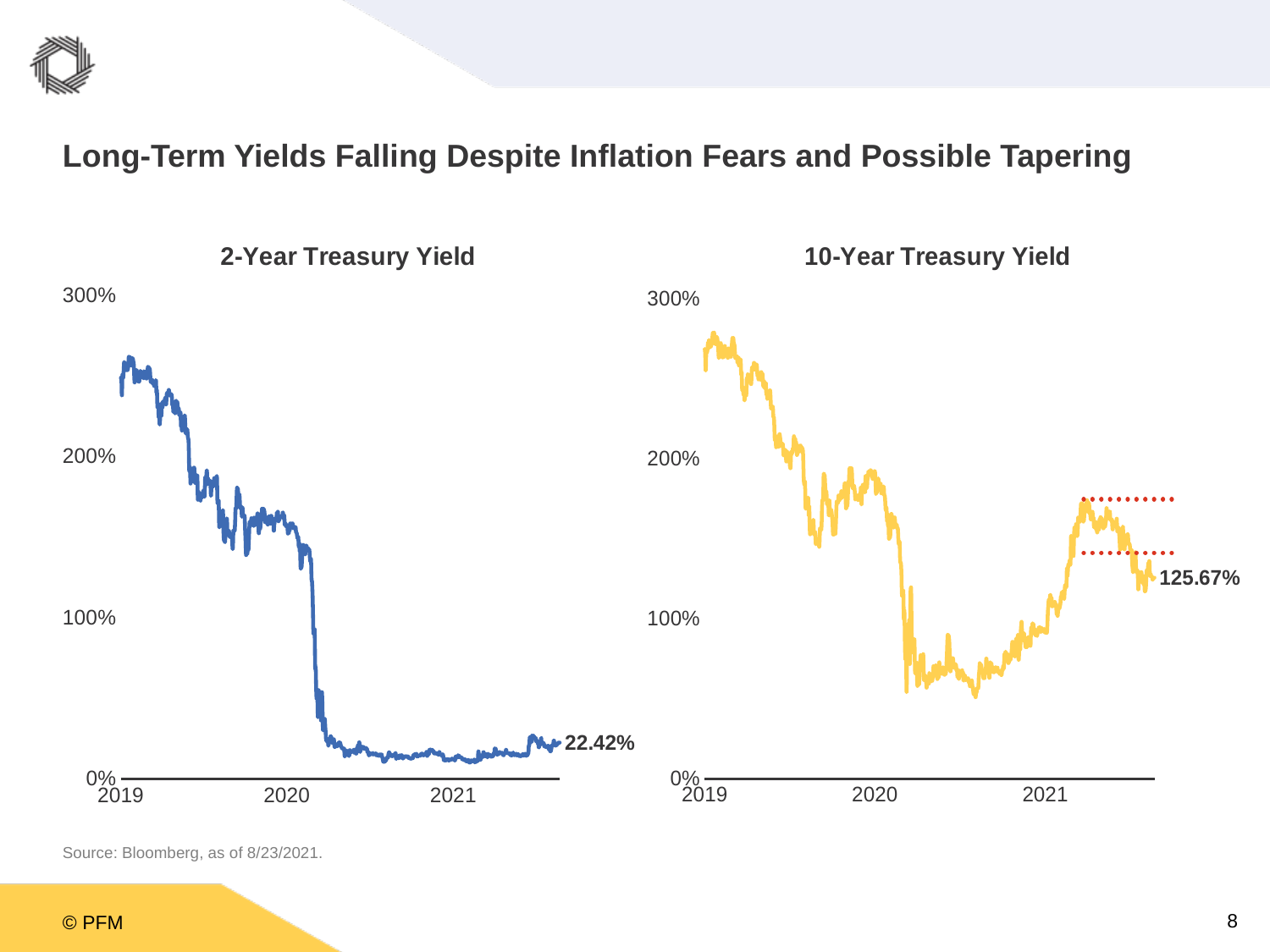
What kind of chart is the 10-Year Treasury Yield chart? line chart On the 2-Year Treasury Yield chart, is the value at the start of 2021 greater or less than 100%? less On the 2-Year Treasury Yield chart, is the value at the start of 2019 greater or less than 200%? greater What kind of chart is the 2-Year Treasury Yield chart? line chart On the 10-Year Treasury Yield chart, is the value at the start of 2020 greater or less than 100%? greater What is the difference between the final values printed on the 10-Year and 2-Year Treasury Yield charts? 103.25% On the 10-Year Treasury Yield chart, what is the value printed at the end of the line? 125.67% On the 2-Year Treasury Yield chart, does the yield rise or fall from 2019 to 2021 overall? fall What is the title of the slide? Long-Term Yields Falling Despite Inflation Fears and Possible Tapering On the 10-Year Treasury Yield chart, does the yield rise or fall from 2019 to 2021 overall? fall On the 2-Year Treasury Yield chart, what is the value printed at the end of the line? 22.42% Which chart ends at a higher value, the 2-Year Treasury Yield chart or the 10-Year Treasury Yield chart? 10-Year Treasury Yield